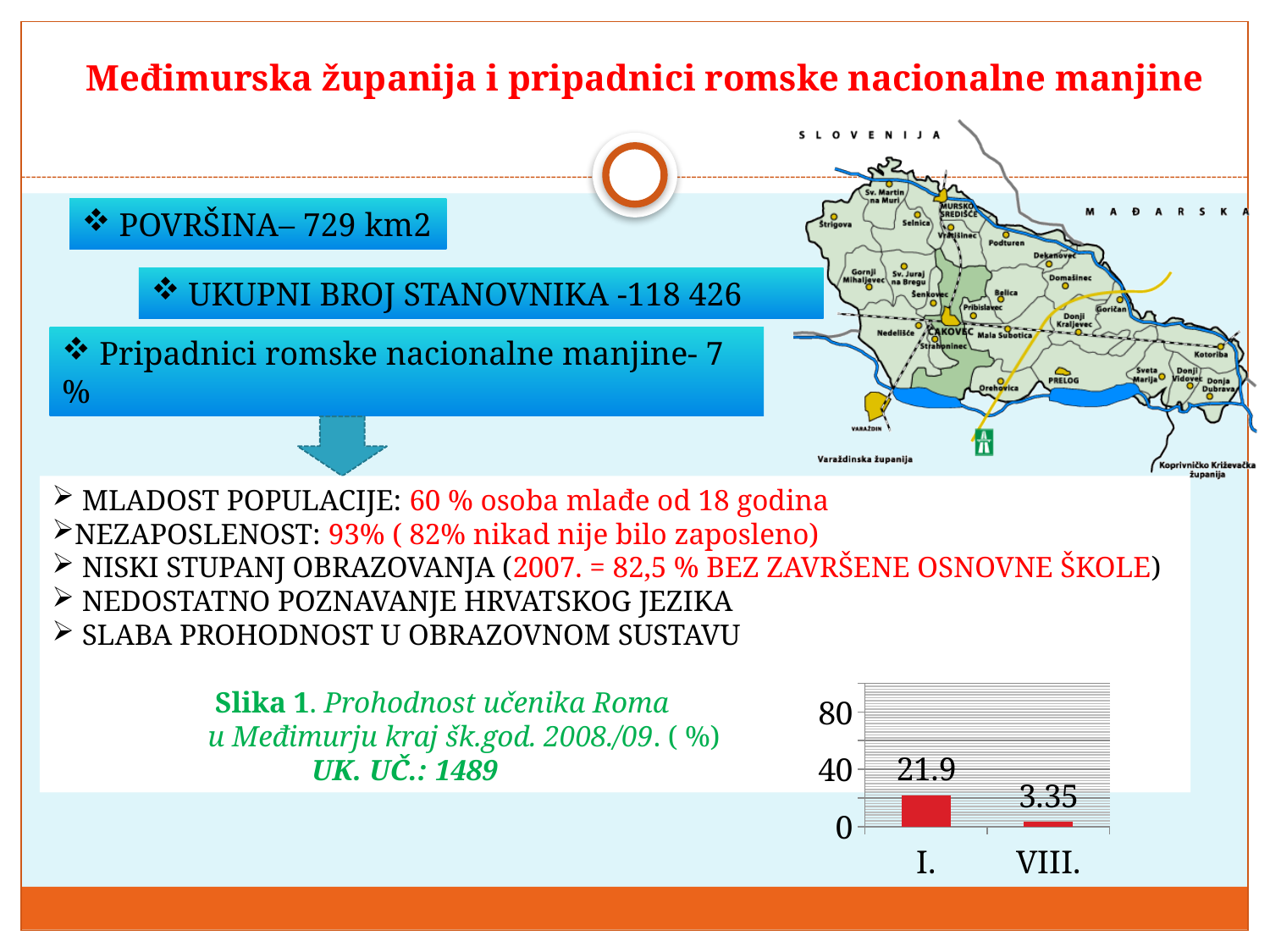
What colour are the bars in the bar chart? red What is the value for category I. in the bar chart? 21.9 Which is larger in the bar chart, the value for I. or the value for VIII.? I. What is the value for category VIII. in the bar chart? 3.35 Which category has the lowest value in the bar chart? VIII. Is the value for I. in the bar chart greater or less than 40? less What is the highest tick value shown on the vertical axis of the bar chart? 80 What is the difference between the values for I. and VIII. in the bar chart? 18.55 What kind of chart is shown at the bottom right of the slide? bar chart Do the values in the bar chart rise or fall from I. to VIII.? fall Which category has the highest value in the bar chart? I. How many categories are shown in the bar chart? 2